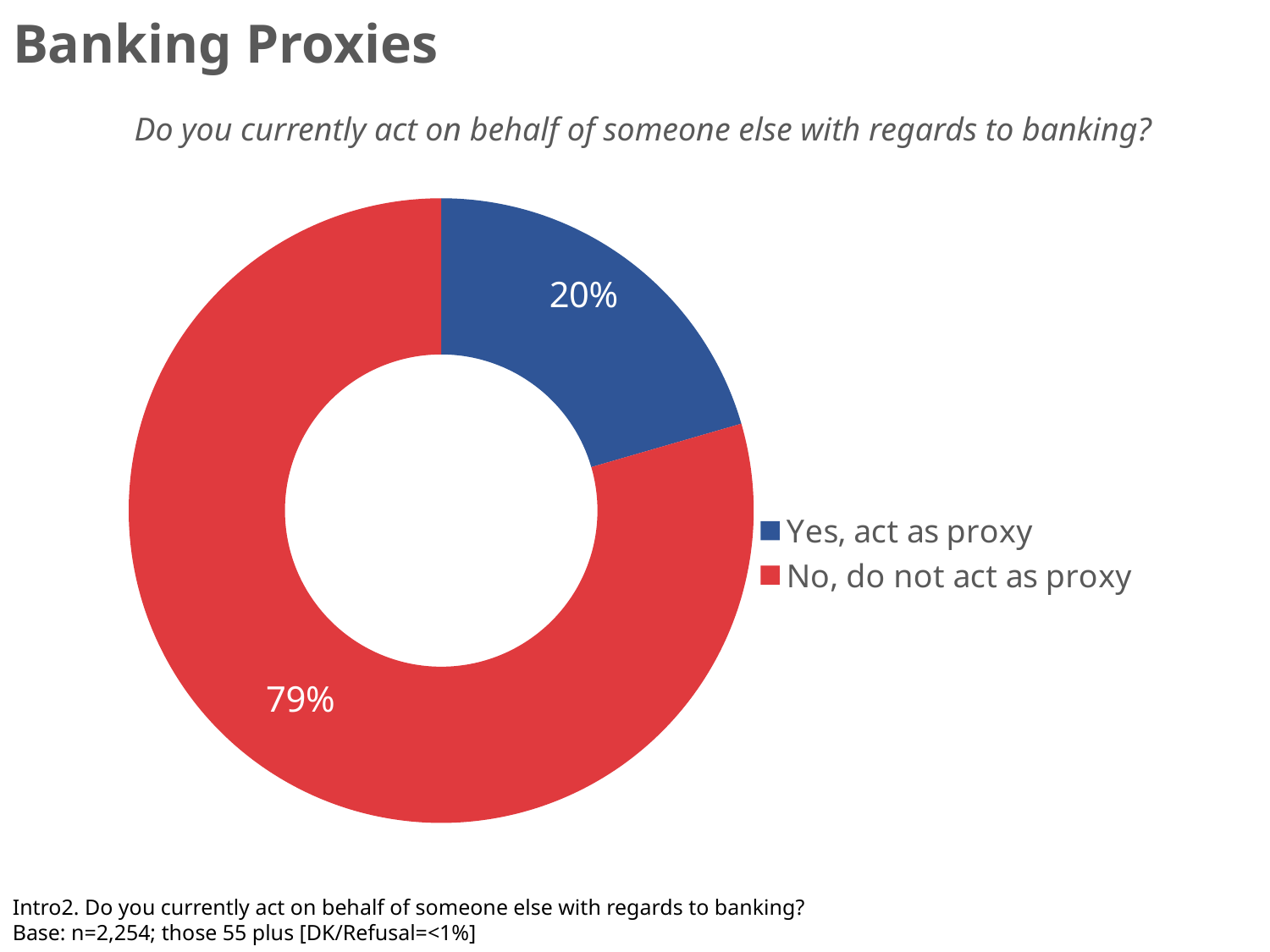
What kind of chart is shown on the slide? Pie (doughnut) chart Which is larger: the share for 'Yes, act as proxy' or 'No, do not act as proxy'? No, do not act as proxy What colour represents 'No, do not act as proxy' in the chart? Red What percentage of respondents say they act as a banking proxy? 20% Which category has the smallest share of the chart? Yes, act as proxy What is the sample size (base) stated on the slide? n=2,254 Which category has the largest share of the chart? No, do not act as proxy What share of the pie does the 'Yes, act as proxy' slice represent? 20% How many entries does the legend list? 2 What percentage of respondents say they do not act as a banking proxy? 79% How many categories are shown in the chart? 2 What is the difference in percentage points between those who do not act as proxy and those who do? 59